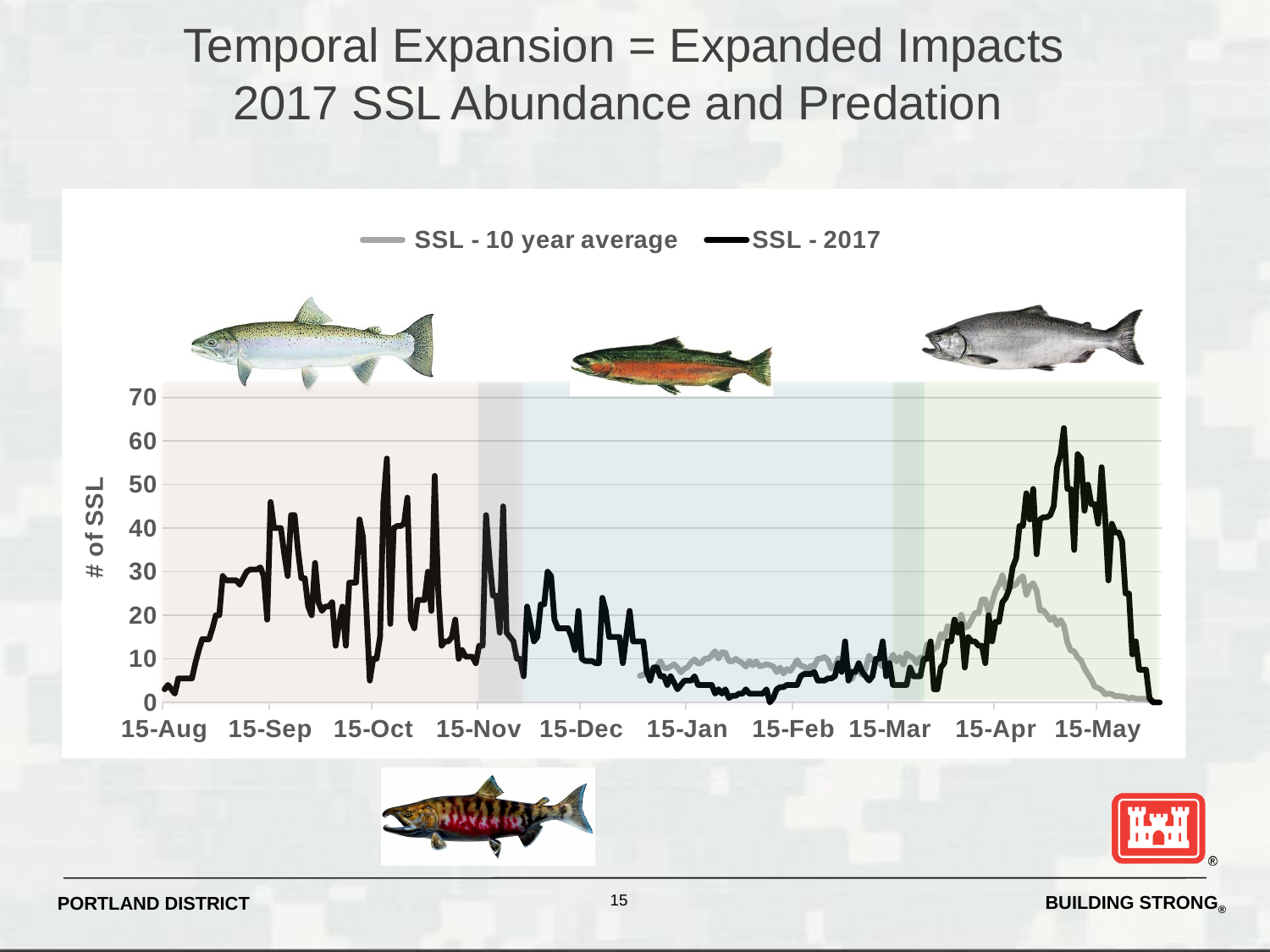
Is the highest value of the SSL - 10 year average series greater or less than 40? less Is the value of the SSL - 10 year average series around 15-Jan greater or less than 20? less Which series is drawn with the black line? SSL - 2017 Does the SSL - 10 year average series rise or fall between 15-Apr and 15-May? fall How many date labels are shown along the x axis? 10 Around 15-May, which series has the higher value, SSL - 2017 or SSL - 10 year average? SSL - 2017 What is the title of the vertical axis? # of SSL Is the highest value of the SSL - 2017 series greater or less than 50? greater What kind of chart is shown on the slide? line chart How many series does the legend list? 2 Around 15-Jan, which series has the higher value, SSL - 2017 or SSL - 10 year average? SSL - 10 year average